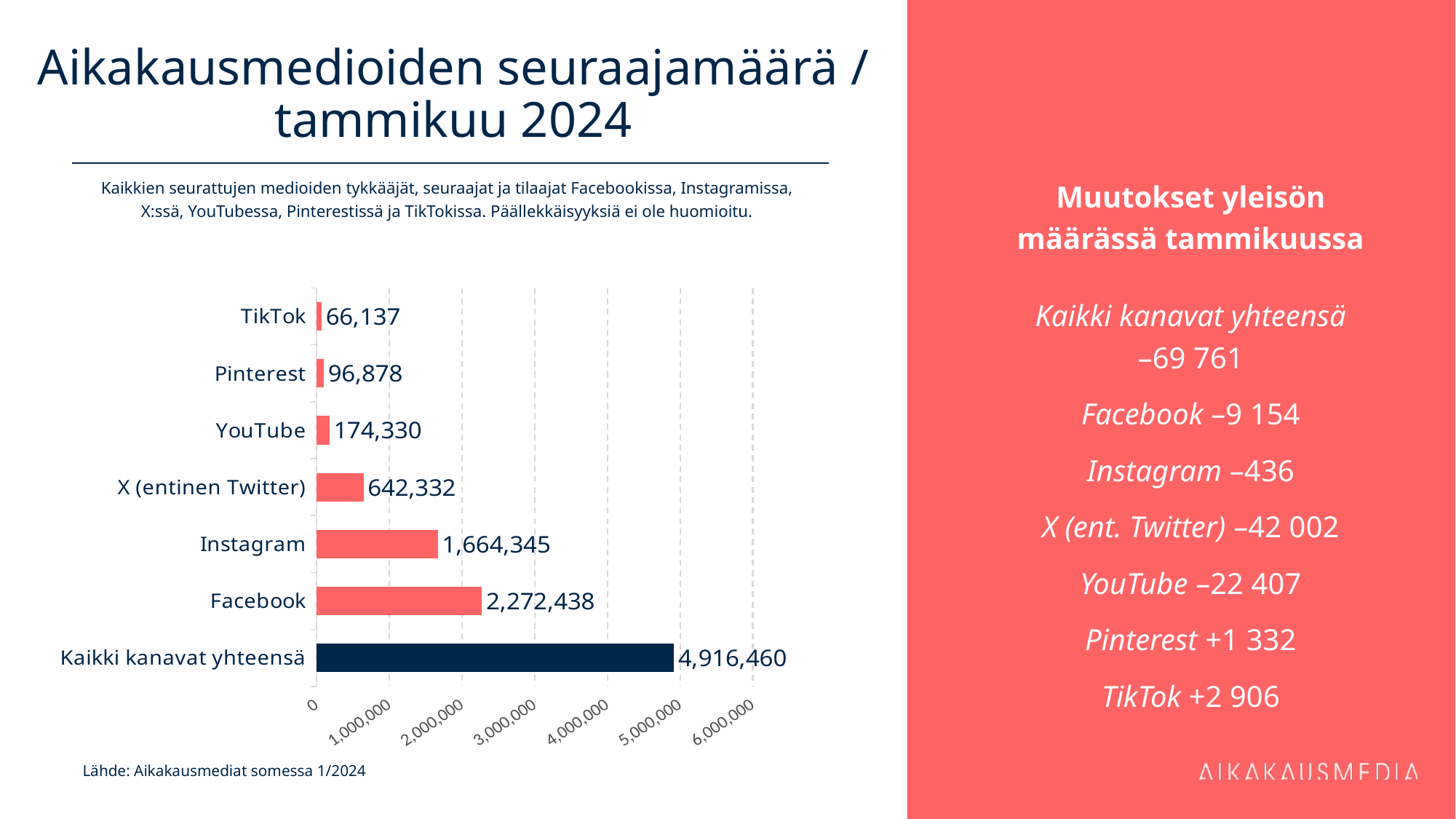
What is the value for X (entinen Twitter)? 642,332 What is the difference between the values for Facebook and Instagram? 608,093 What is the difference between the values for Pinterest and TikTok? 30,741 What kind of chart is shown on the slide? Bar chart Which is larger, the value for Instagram or the value for X (entinen Twitter)? Instagram What is the value for Instagram? 1,664,345 What is the value for TikTok? 66,137 What is the value for Facebook? 2,272,438 Which category has the highest value? Kaikki kanavat yhteensä Which category has the lowest value? TikTok What is the value for Kaikki kanavat yhteensä? 4,916,460 How many categories are shown in the chart? 7